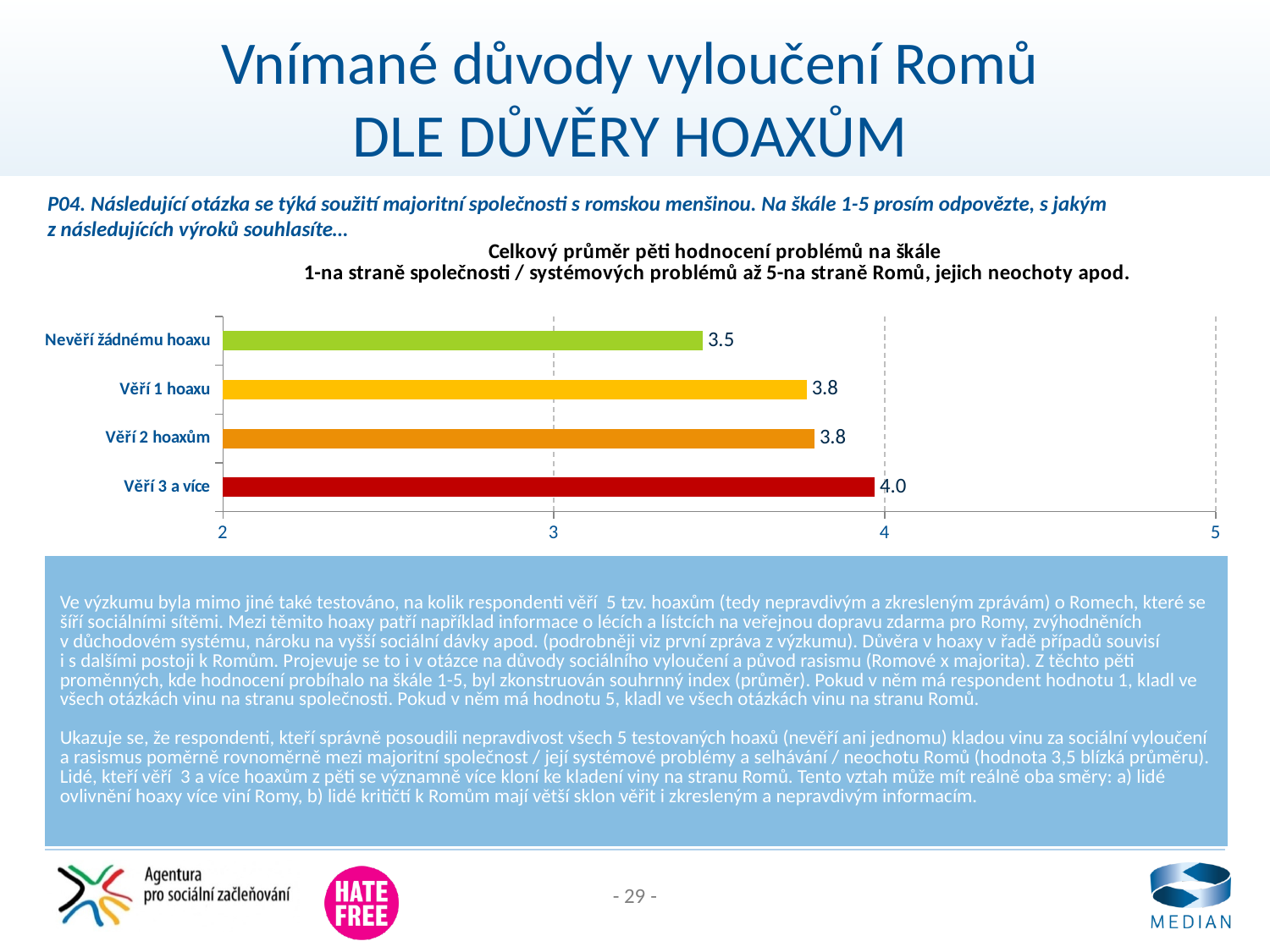
What kind of chart is shown on the slide? bar chart What is the value for "Nevěří žádnému hoaxu"? 3.5 What is the lowest value shown on the horizontal axis of the chart? 2 What is the difference between the values for "Věří 3 a více" and "Nevěří žádnému hoaxu"? 0.5 How many categories are shown in the chart? 4 What is the value for "Věří 3 a více"? 4.0 Which category has the lowest value? Nevěří žádnému hoaxu Which is larger, the value for "Věří 1 hoaxu" or the value for "Nevěří žádnému hoaxu"? Věří 1 hoaxu Is the value for "Věří 2 hoaxům" greater or less than 4? less Which category has the highest value? Věří 3 a více What is the value for "Věří 2 hoaxům"? 3.8 What is the value for "Věří 1 hoaxu"? 3.8